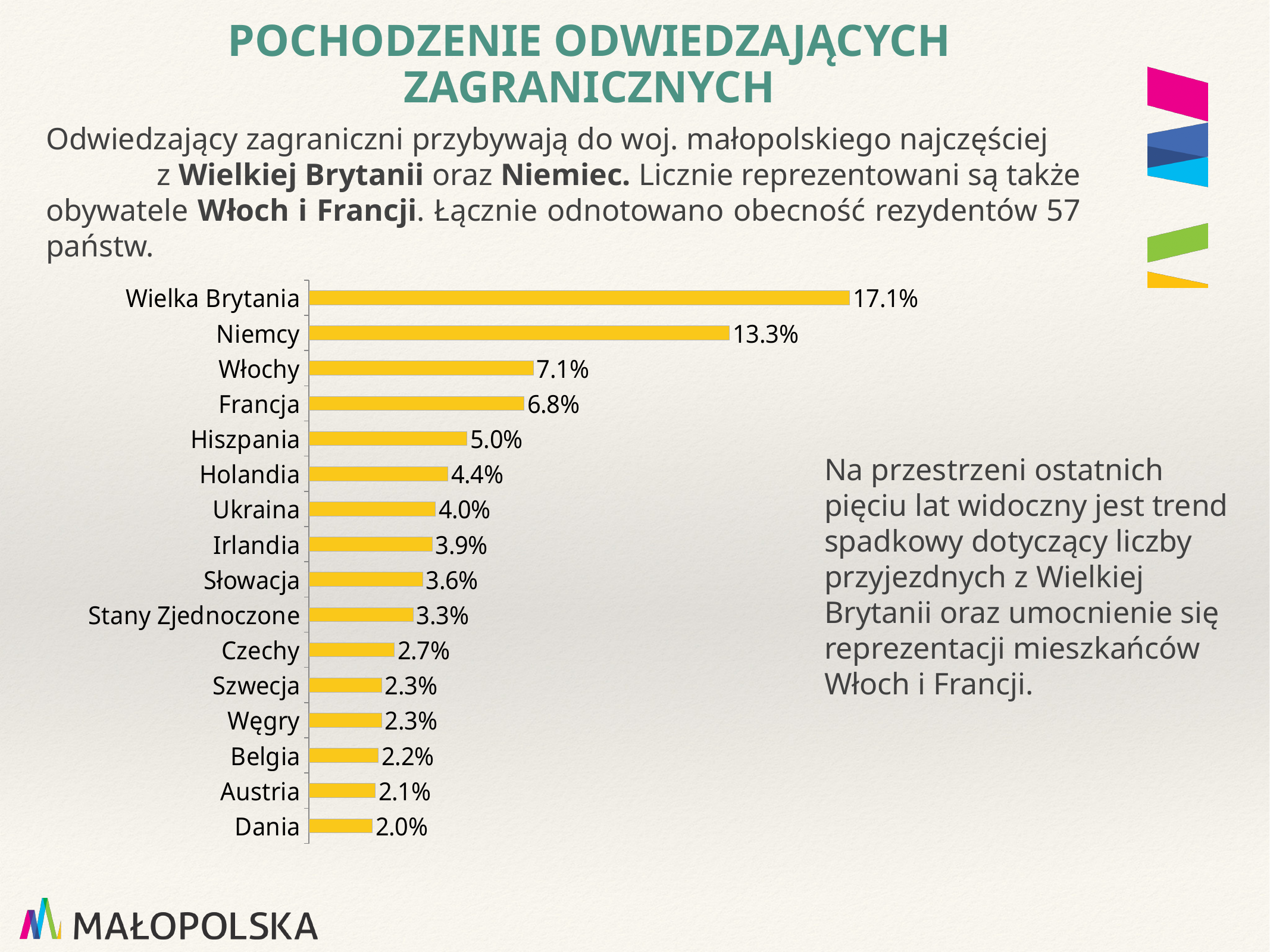
What is the value for Stany Zjednoczone? 3.3% How many categories are shown in the chart? 16 What is the value for Wielka Brytania? 17.1% What is the value for Niemcy? 13.3% Which category has the lowest value? Dania Which is larger, the value for Holandia or the value for Ukraina? Holandia What is the difference between the values for Wielka Brytania and Niemcy? 3.8% What kind of chart is shown on the slide? Bar chart What is the value for Hiszpania? 5.0% What is the difference between the values for Włochy and Francja? 0.3% Which category has the highest value? Wielka Brytania What colour are the bars in the chart? Yellow